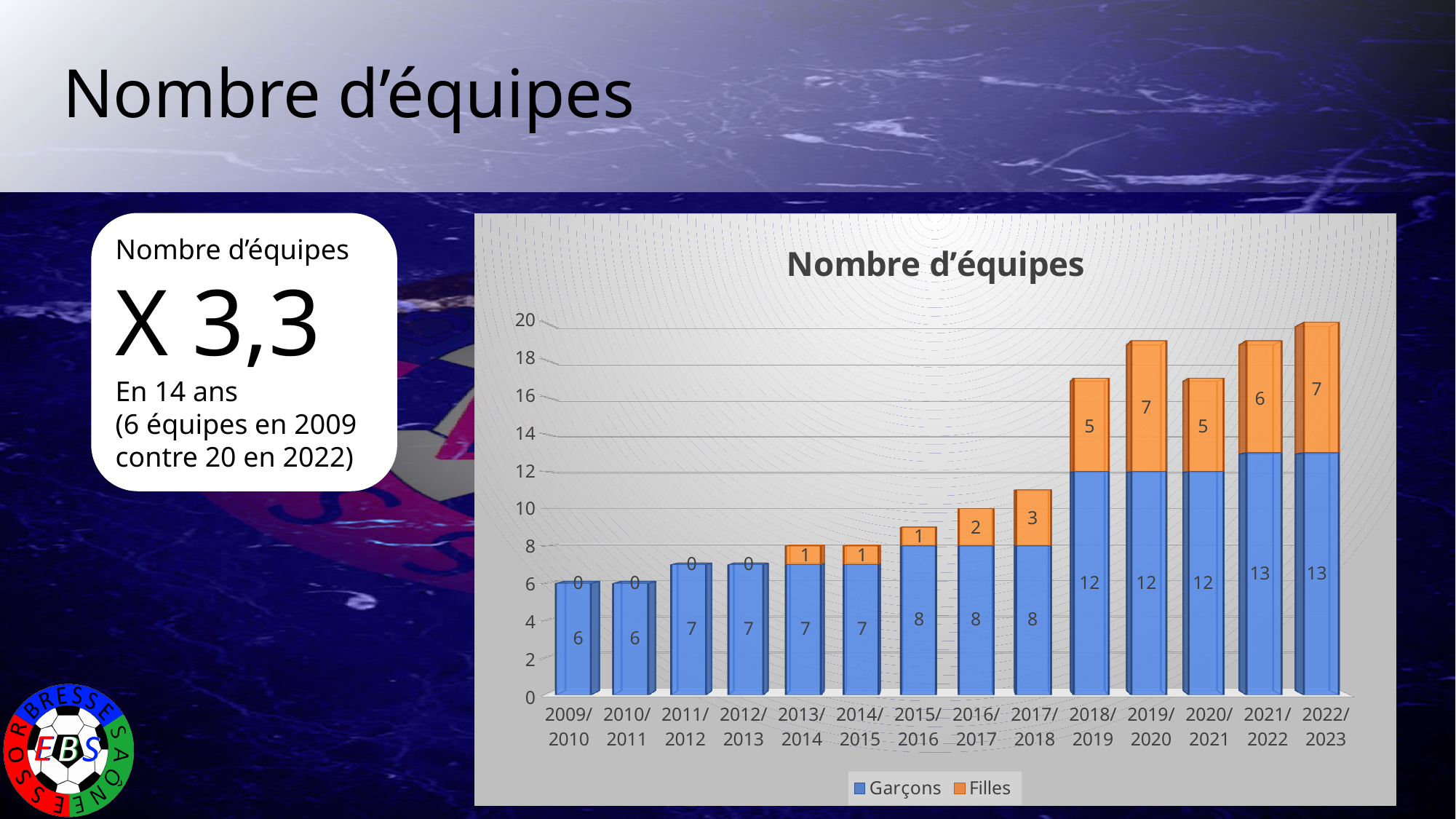
What is the total of the stacked bar for the 2022/2023 season? 20 What is the total of the stacked bar for the 2017/2018 season? 11 What is the value for Garçons in the 2018/2019 season? 12 How many series does the legend list in the 'Nombre d'équipes' chart? 2 Which season has the highest Garçons value, 2015/2016 or 2021/2022? 2021/2022 What is the value for Filles in the 2019/2020 season? 7 What is the value for Filles in the 2013/2014 season? 1 What is the difference between the Garçons value in 2022/2023 and the Garçons value in 2009/2010? 7 Do the Garçons values generally rise or fall from 2009/2010 to 2022/2023? Rise Which season has the lowest total number of teams? 2009/2010 and 2010/2011 (6 each) What type of chart is shown on the slide? Stacked bar chart How many seasons (categories) are shown on the x axis of the chart? 14